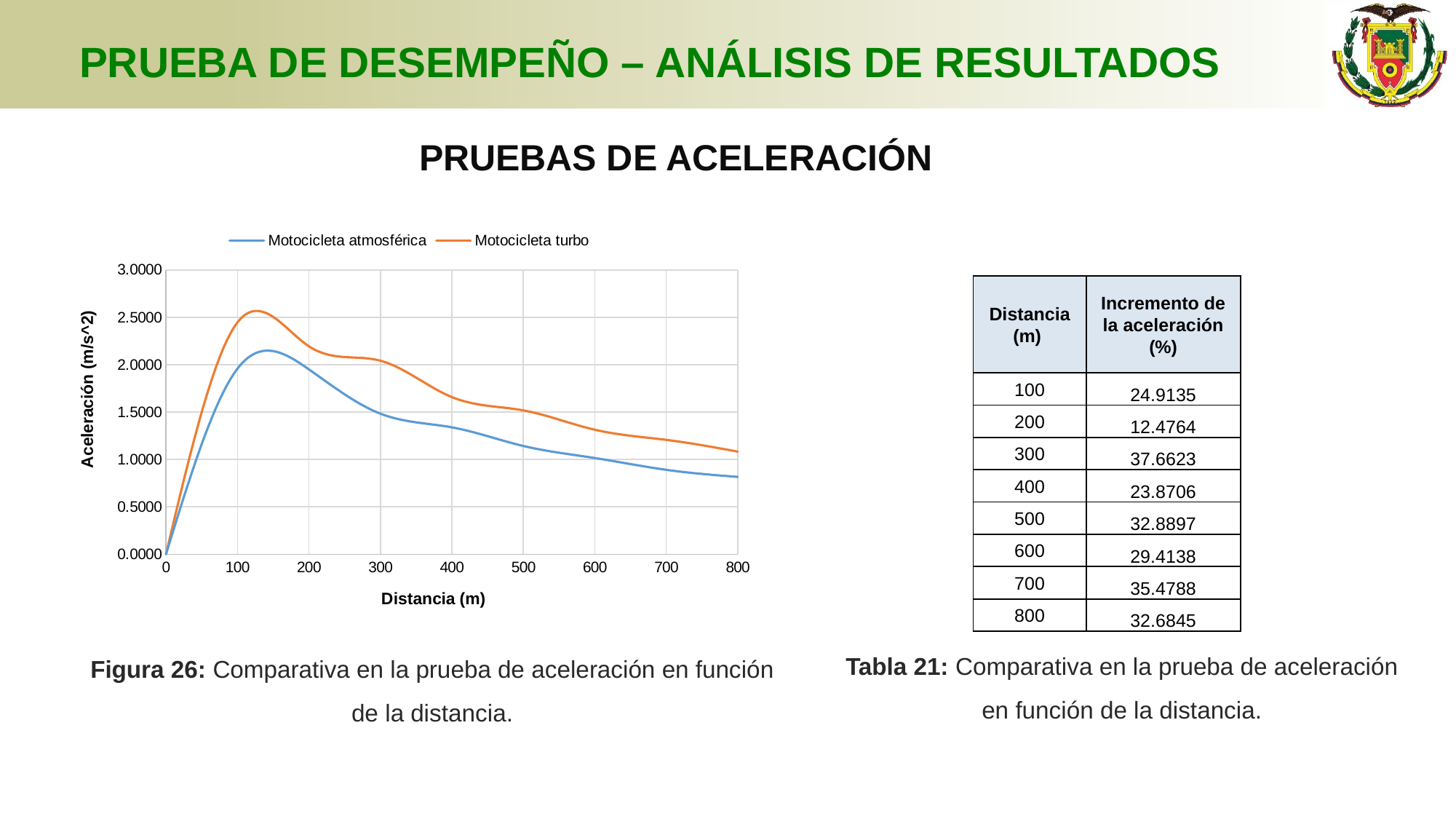
What kind of chart is shown in Figura 26? Line chart Between 200 m and 800 m, does the Motocicleta turbo series rise or fall? Fall Is the value for Motocicleta turbo at 200 m greater or less than 2.0000? greater Is the value for Motocicleta turbo at 600 m greater or less than 1.0000? greater What is the title of the vertical axis of the chart? Aceleración (m/s^2) How many series does the legend of the chart list? 2 Is the value for Motocicleta atmosférica at 800 m greater or less than 1.0000? less What are the two series named in the chart legend? Motocicleta atmosférica and Motocicleta turbo At 400 m, which series has the higher acceleration, Motocicleta atmosférica or Motocicleta turbo? Motocicleta turbo